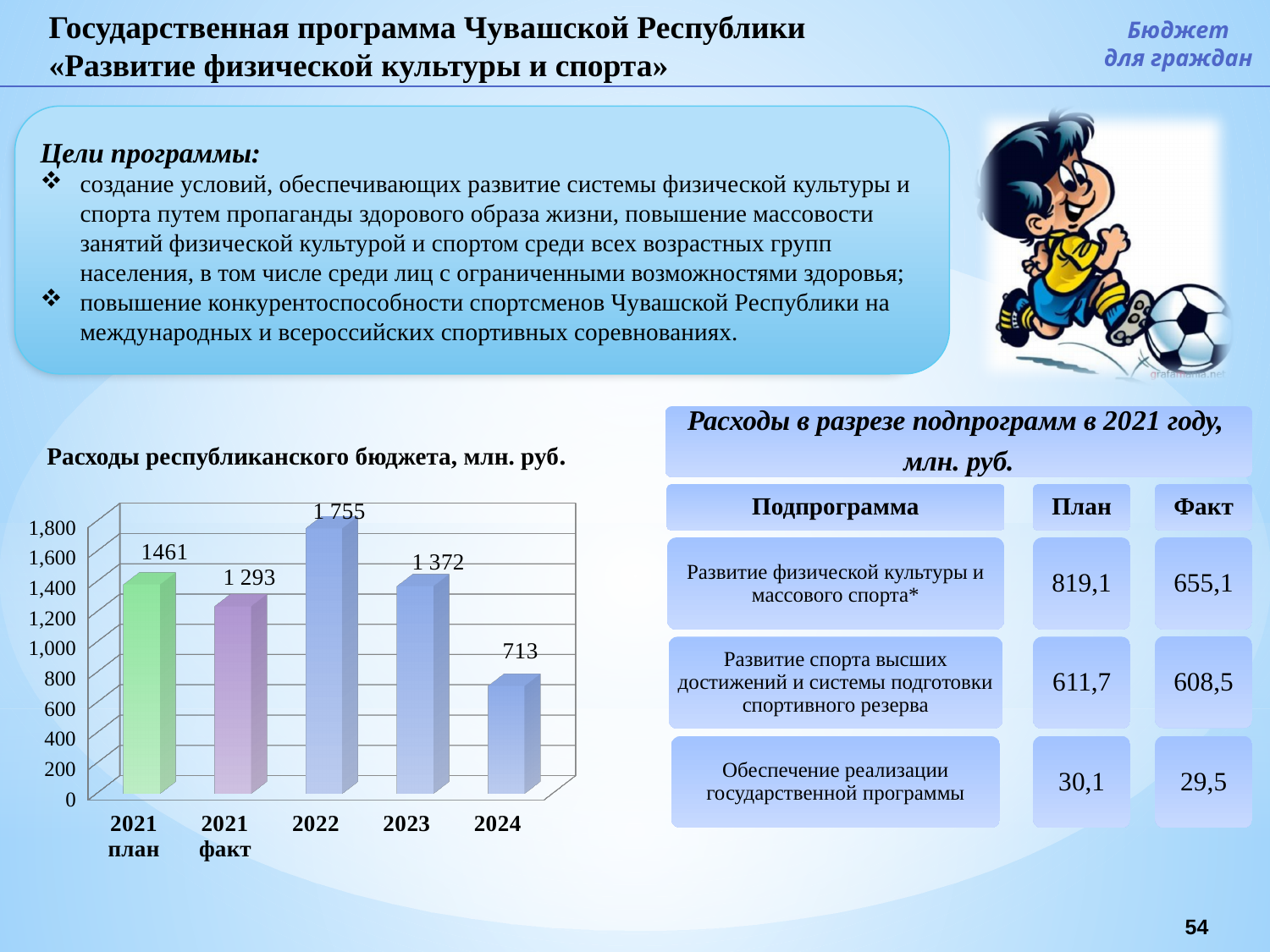
In the chart 'Расходы республиканского бюджета, млн. руб.', what is the difference between '2021 план' and '2021 факт'? 168 In the chart 'Расходы республиканского бюджета, млн. руб.', do the values rise or fall from 2022 to 2024? fall In the chart 'Расходы республиканского бюджета, млн. руб.', which is larger: the value for 2023 or the value for '2021 факт'? 2023 What is the value for 2024 in the chart 'Расходы республиканского бюджета, млн. руб.'? 713 Which category has the lowest value in the chart 'Расходы республиканского бюджета, млн. руб.'? 2024 In the chart 'Расходы республиканского бюджета, млн. руб.', what is the difference between the values for 2022 and 2023? 383 How many bars are shown in the chart 'Расходы республиканского бюджета, млн. руб.'? 5 What is the value for '2021 план' in the chart 'Расходы республиканского бюджета, млн. руб.'? 1461 What type of chart is 'Расходы республиканского бюджета, млн. руб.'? bar chart Which category has the highest value in the chart 'Расходы республиканского бюджета, млн. руб.'? 2022 What is the value for '2021 факт' in the chart 'Расходы республиканского бюджета, млн. руб.'? 1 293 What is the value for 2022 in the chart 'Расходы республиканского бюджета, млн. руб.'? 1 755